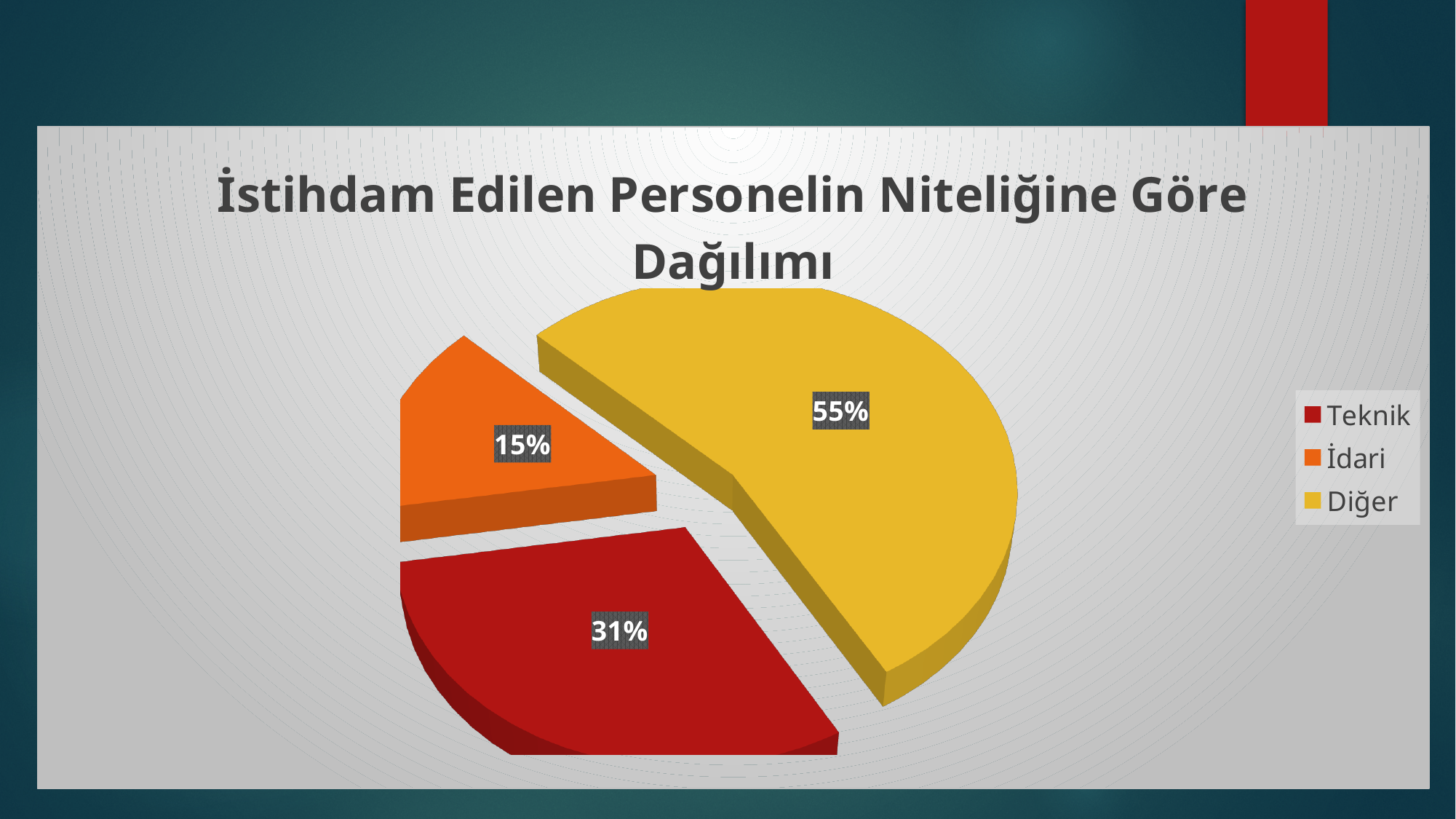
What share of the pie does Teknik have? 31% How many entries does the legend list? 3 What colour is the Diğer slice? Yellow What is the title of the chart? İstihdam Edilen Personelin Niteliğine Göre Dağılımı Which category has the smallest slice of the pie? İdari What is the difference in percentage points between Diğer and Teknik? 24 What share of the pie does İdari have? 15% How many slices does the pie chart have? 3 What share of the pie does Diğer have? 55% Which category has the largest slice of the pie? Diğer What kind of chart is shown on the slide? Pie chart Which is larger, the Teknik slice or the İdari slice? Teknik